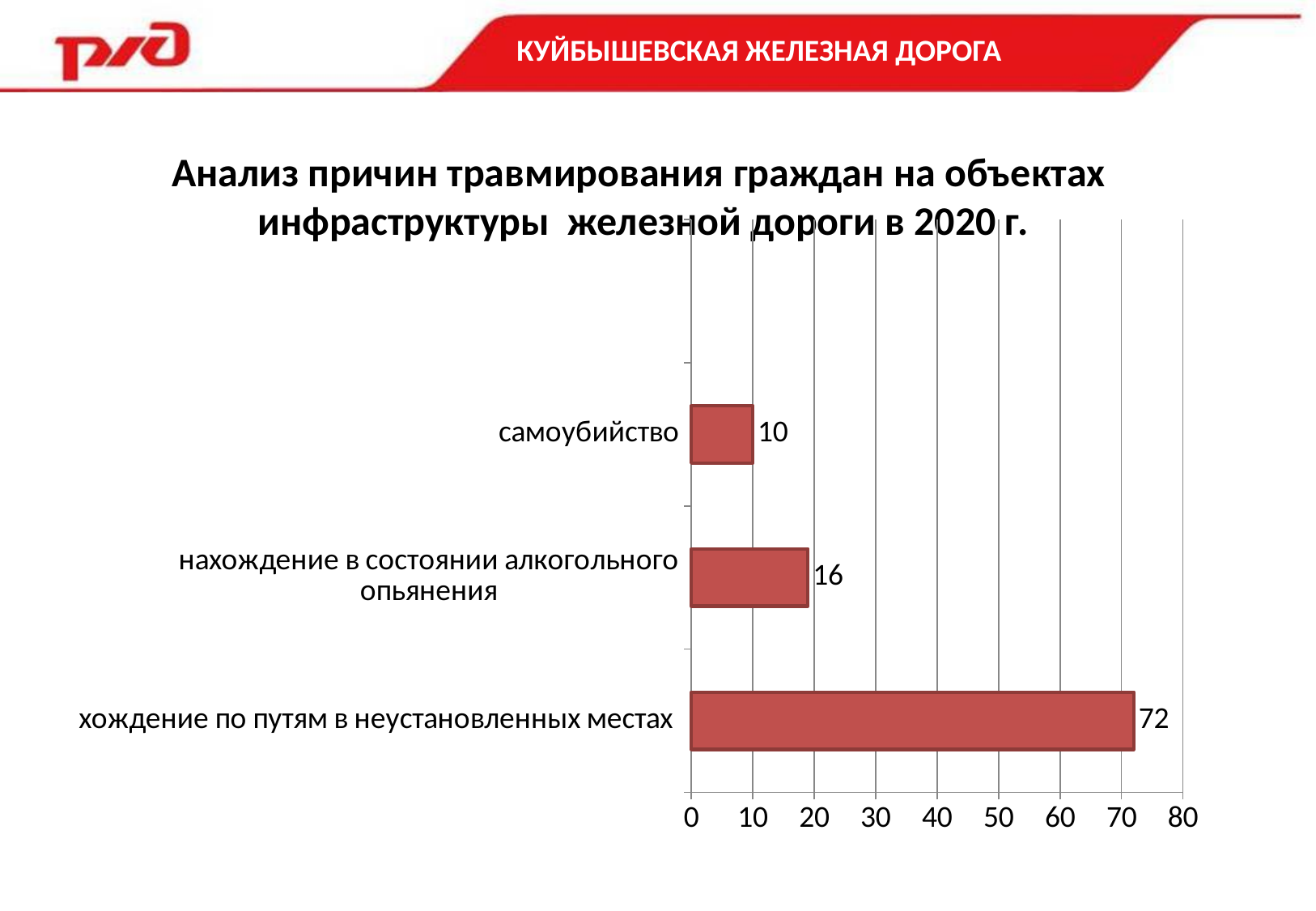
How many categories are shown in the chart? 3 What is the maximum value shown on the horizontal axis? 80 What is the difference between the values for 'нахождение в состоянии алкогольного опьянения' and 'самоубийство'? 6 What is the value for 'нахождение в состоянии алкогольного опьянения'? 16 What kind of chart is shown on the slide? bar chart Which category has the highest value? хождение по путям в неустановленных местах What is the value for 'хождение по путям в неустановленных местах'? 72 Which category has the lowest value? самоубийство Is the value for 'хождение по путям в неустановленных местах' greater or less than 50? greater What is the difference between the values for 'хождение по путям в неустановленных местах' and 'нахождение в состоянии алкогольного опьянения'? 56 Which is larger: the value for 'нахождение в состоянии алкогольного опьянения' or for 'самоубийство'? нахождение в состоянии алкогольного опьянения What is the value for 'самоубийство'? 10